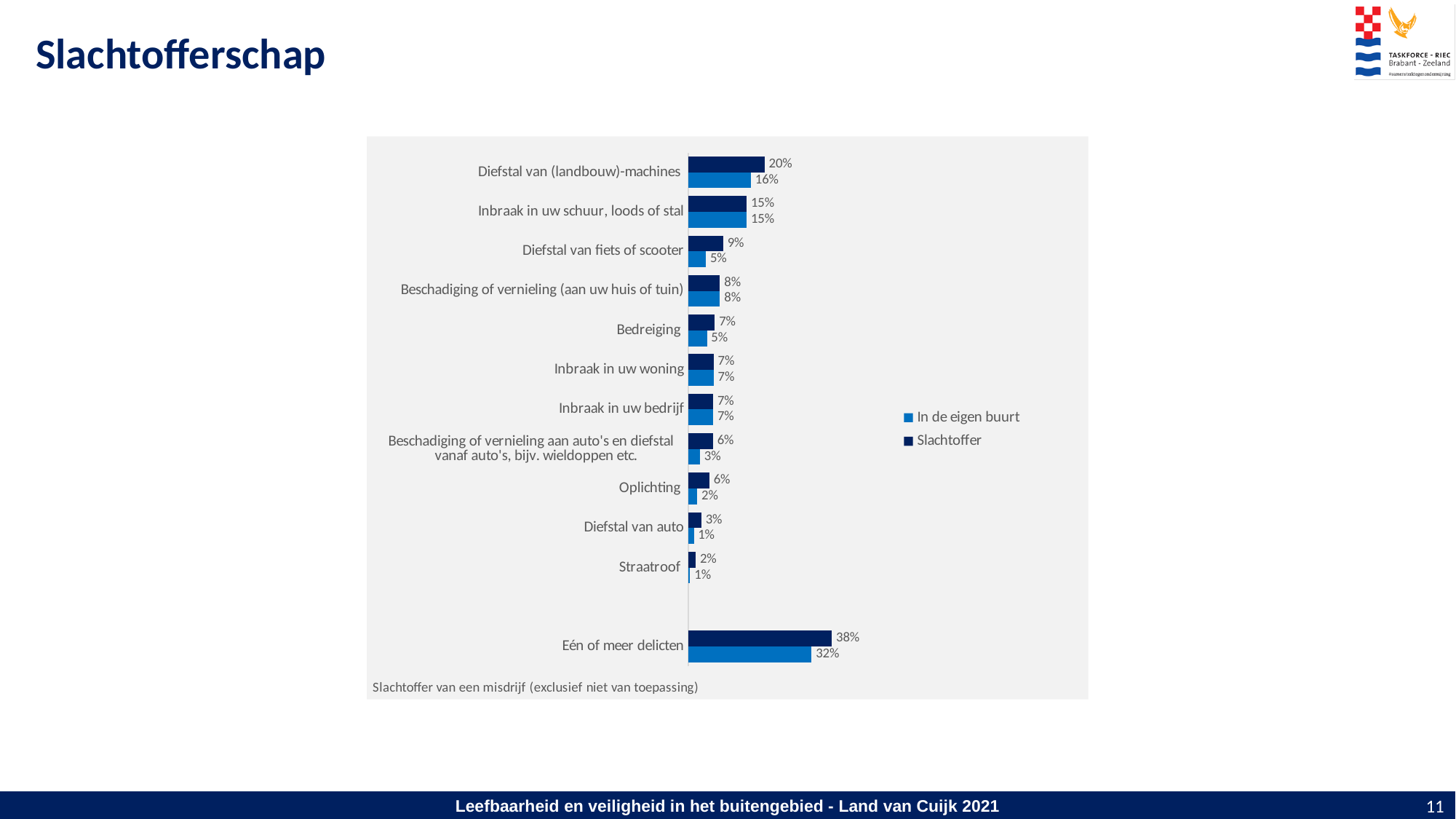
What is the In de eigen buurt value for Eén of meer delicten? 32% Which series is shown in dark blue in the legend? Slachtoffer Which category has the highest Slachtoffer value? Eén of meer delicten Which category has the lowest Slachtoffer value? Straatroof How many series does the legend list? 2 How many categories are shown on the chart? 12 What is the In de eigen buurt value for Oplichting? 2% What kind of chart is shown on the slide? Bar chart What is the difference between the Slachtoffer and In de eigen buurt values for Diefstal van fiets of scooter? 4% What is the Slachtoffer value for Diefstal van (landbouw)-machines? 20% Which is larger: the Slachtoffer value for Bedreiging or the Slachtoffer value for Diefstal van auto? Bedreiging What is the difference between the Slachtoffer values for Eén of meer delicten and Diefstal van (landbouw)-machines? 18%